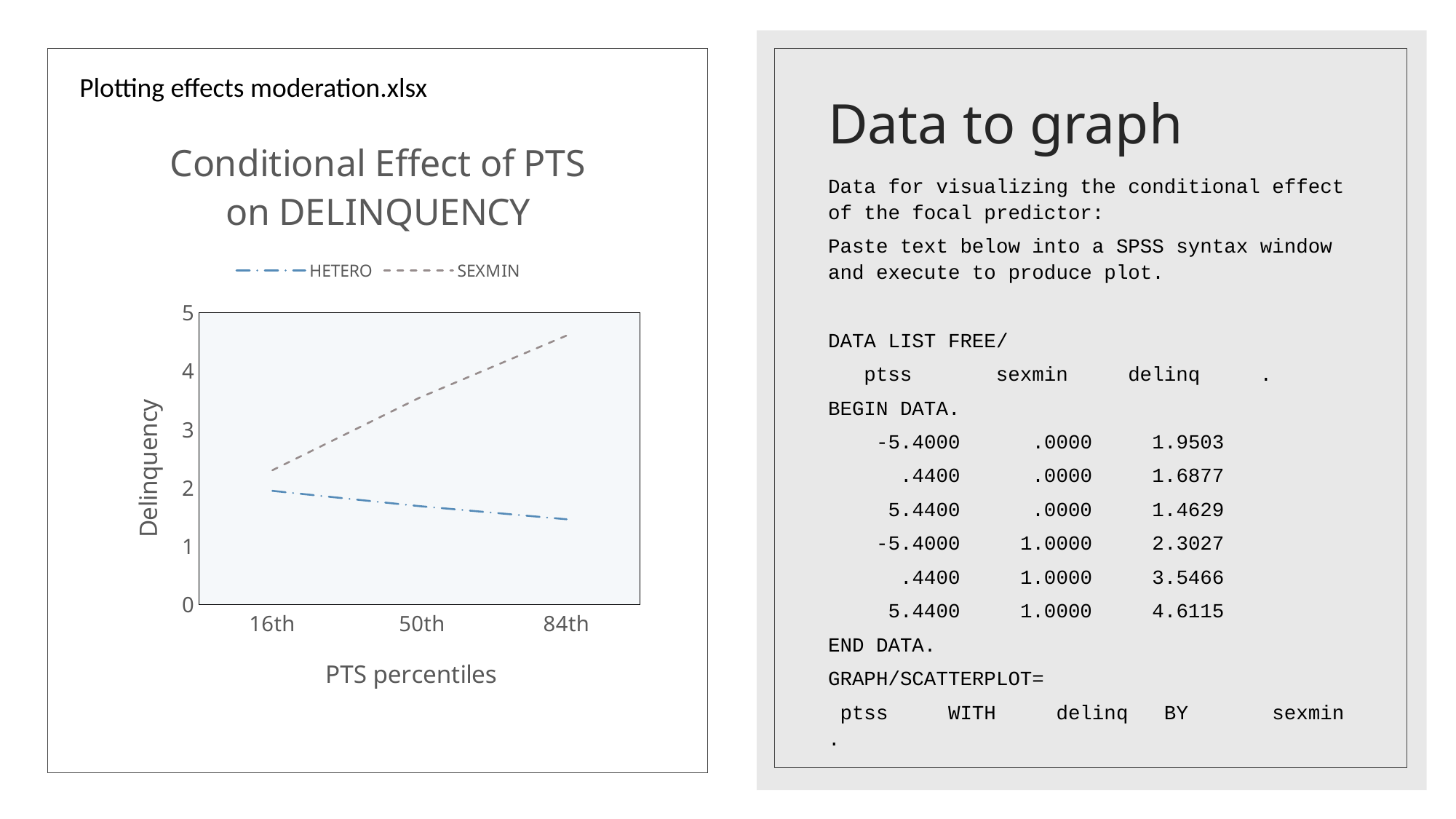
How many PTS percentile categories are shown on the x axis? 3 How many series does the chart legend list? 2 Does the SEXMIN line rise or fall from the 16th to the 84th percentile? rise Is the SEXMIN value at the 50th percentile greater or less than 3? greater Is the SEXMIN value at the 84th percentile greater or less than 4? greater At the 84th percentile, which series has the higher Delinquency value, HETERO or SEXMIN? SEXMIN Is the HETERO value at the 84th percentile greater or less than 2? less What kind of chart is shown on the slide? line chart What is the label of the chart's y axis? Delinquency Does the HETERO line rise or fall from the 16th to the 84th percentile? fall What is the title of the chart? Conditional Effect of PTS on DELINQUENCY